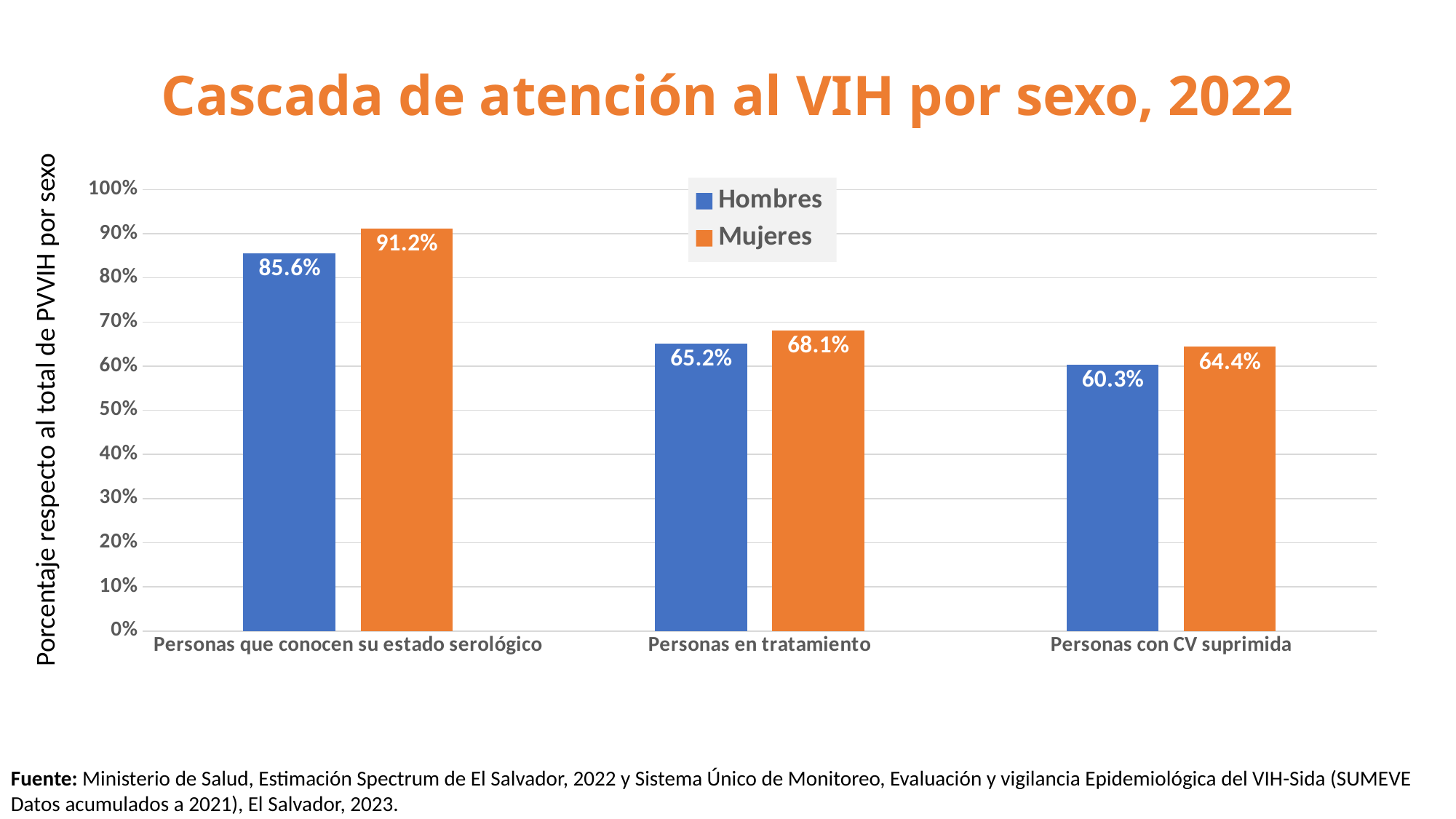
What is the value for Hombres in the 'Personas que conocen su estado serológico' category? 85.6% What is the value for Hombres in the 'Personas con CV suprimida' category? 60.3% How many series does the legend list? 2 Which category has the lowest value for Hombres? Personas con CV suprimida In the 'Personas con CV suprimida' category, which series has the larger value, Hombres or Mujeres? Mujeres Is the value for Mujeres in 'Personas que conocen su estado serológico' greater or less than 90%? greater Which category has the highest value for Mujeres? Personas que conocen su estado serológico What is the value for Mujeres in the 'Personas en tratamiento' category? 68.1% What kind of chart is shown on the slide? Bar chart Do the Hombres values rise or fall from left to right across the categories? Fall What is the difference between the Mujeres and Hombres values in the 'Personas que conocen su estado serológico' category? 5.6% How many categories are shown on the x axis? 3